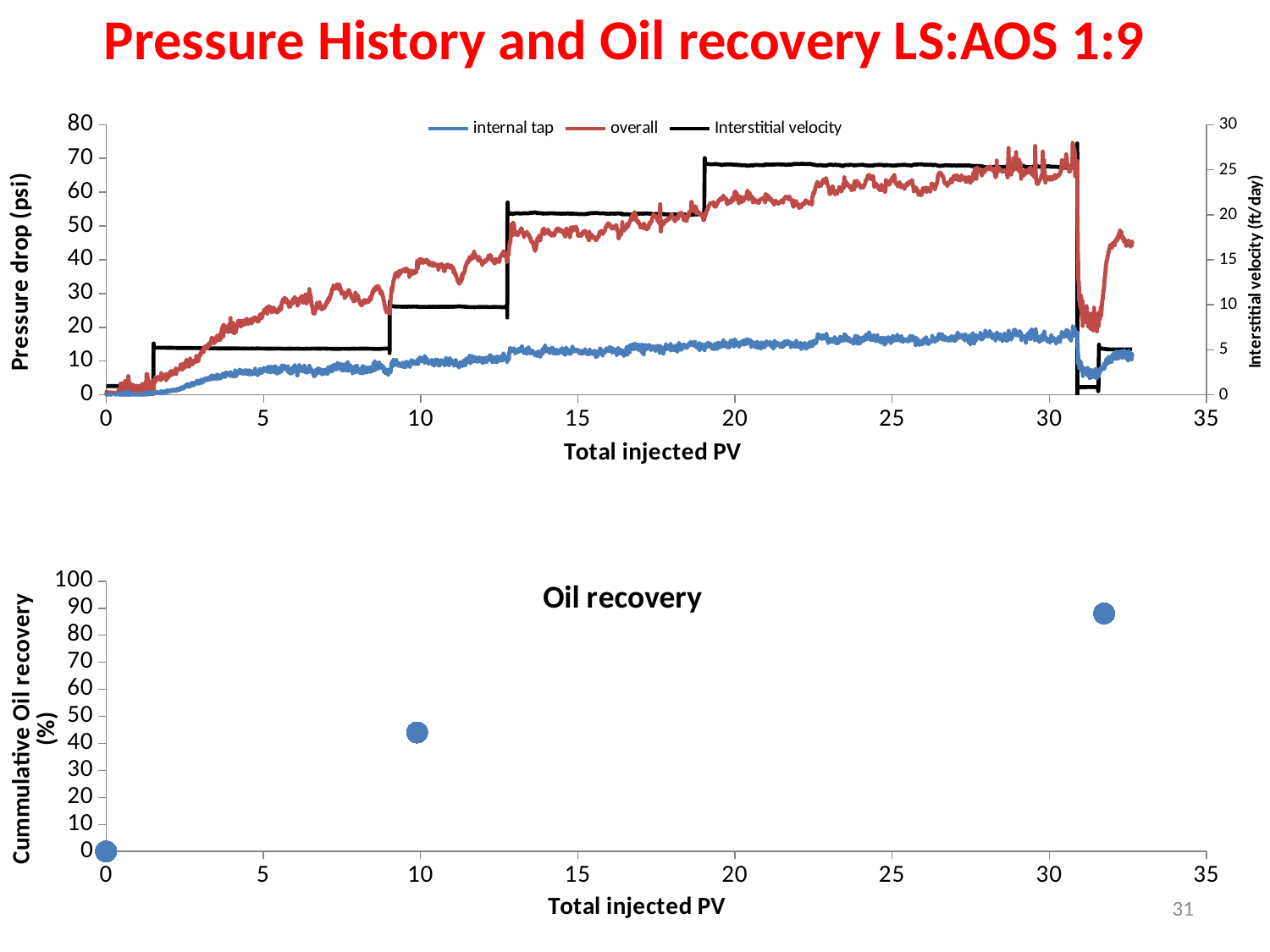
In the top chart, how many series does the legend list? 3 In the top chart, which series is drawn in black? Interstitial velocity What is the label of the left vertical axis of the top chart? Pressure drop (psi) In the top chart, is the 'internal tap' pressure drop at 25 total injected PV greater or less than 20 psi? less In the top chart, does the 'internal tap' pressure drop generally rise or fall between 0 and 30 total injected PV? rise What kind of chart is the top chart on the slide? line chart In the bottom 'Oil recovery' chart, is the cumulative oil recovery at about 32 total injected PV greater or less than 80%? greater In the bottom 'Oil recovery' chart, is the cumulative oil recovery at about 10 total injected PV greater or less than 50%? less In the top chart, at 20 total injected PV, which series has the larger pressure drop: 'overall' or 'internal tap'? overall How many data points are plotted in the bottom 'Oil recovery' chart? 3 What kind of chart is the bottom chart titled 'Oil recovery'? scatter chart